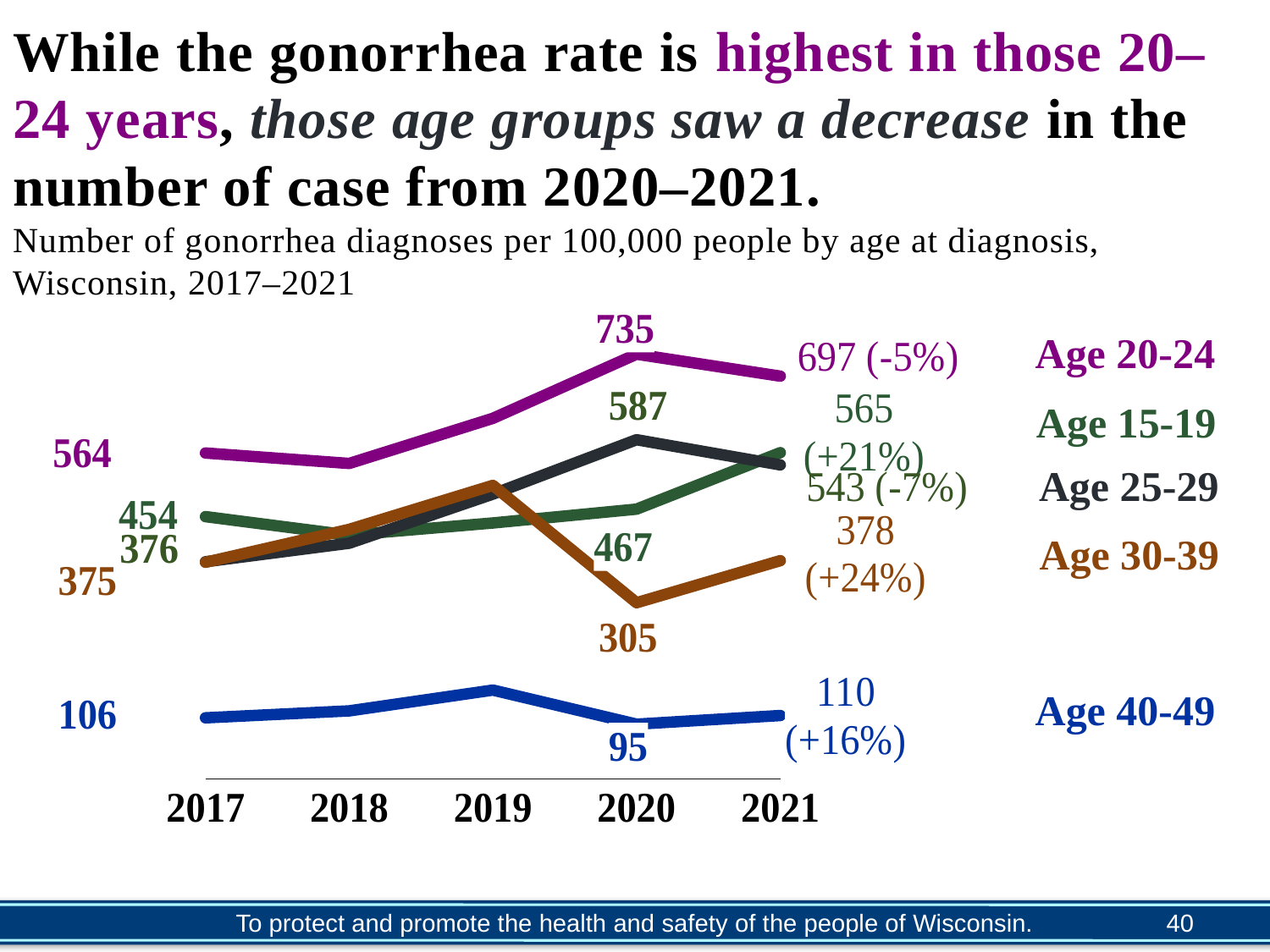
What was the gonorrhea rate for Age 20-24 in 2020? 735 How many age groups (series) are plotted on the chart? 5 Which age group had the lowest gonorrhea rate in 2020? Age 40-49 What was the gonorrhea rate for Age 40-49 in 2017? 106 Which was larger in 2021, the rate for Age 15-19 or the rate for Age 25-29? Age 15-19 How many years are shown on the x axis of the chart? 5 What was the gonorrhea rate for Age 30-39 in 2020? 305 What is the difference between the Age 20-24 rate in 2020 and in 2021? 38 What percent change is shown for Age 30-39 from 2020 to 2021? +24% What type of chart is shown on the slide? line chart What was the gonorrhea rate for Age 20-24 in 2021? 697 Which age group had the highest gonorrhea rate in 2021? Age 20-24